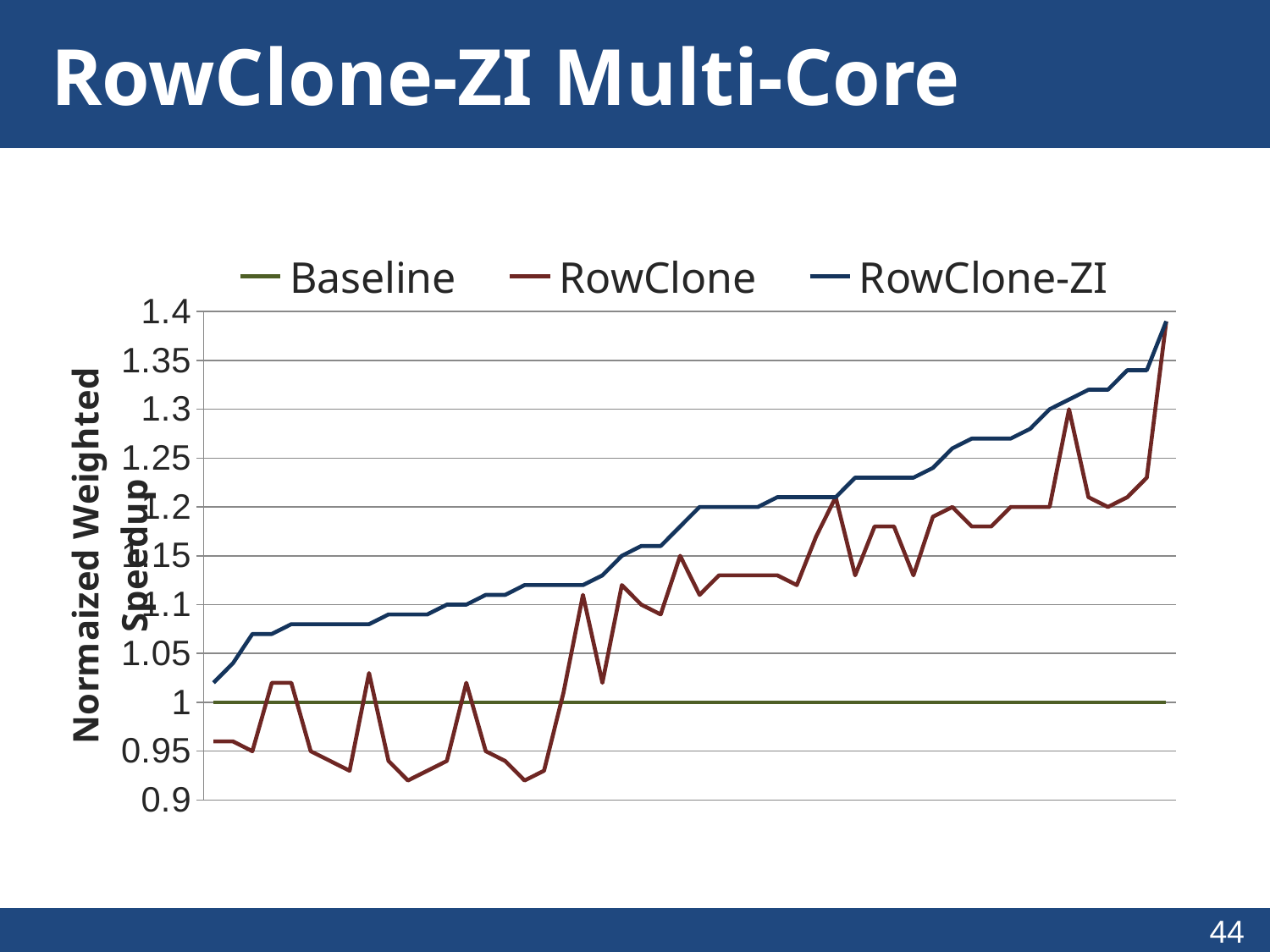
Is the highest value of the RowClone-ZI series greater or less than 1.35? greater What is the label of the y axis? Normalized Weighted Speedup Does the RowClone series ever fall below the Baseline? yes How many series does the legend list? 3 What constant value does the Baseline series hold across the chart? 1 Is the lowest value of the RowClone series greater or less than 0.95? less Which series reaches the lowest value on the chart? RowClone What kind of chart is shown on the slide? line chart Does the RowClone-ZI series rise or fall from left to right? rise At the left end of the chart, which series is higher, RowClone or RowClone-ZI? RowClone-ZI What are the three series named in the legend? Baseline, RowClone, RowClone-ZI Is the leftmost value of the RowClone-ZI series greater or less than 1.05? less